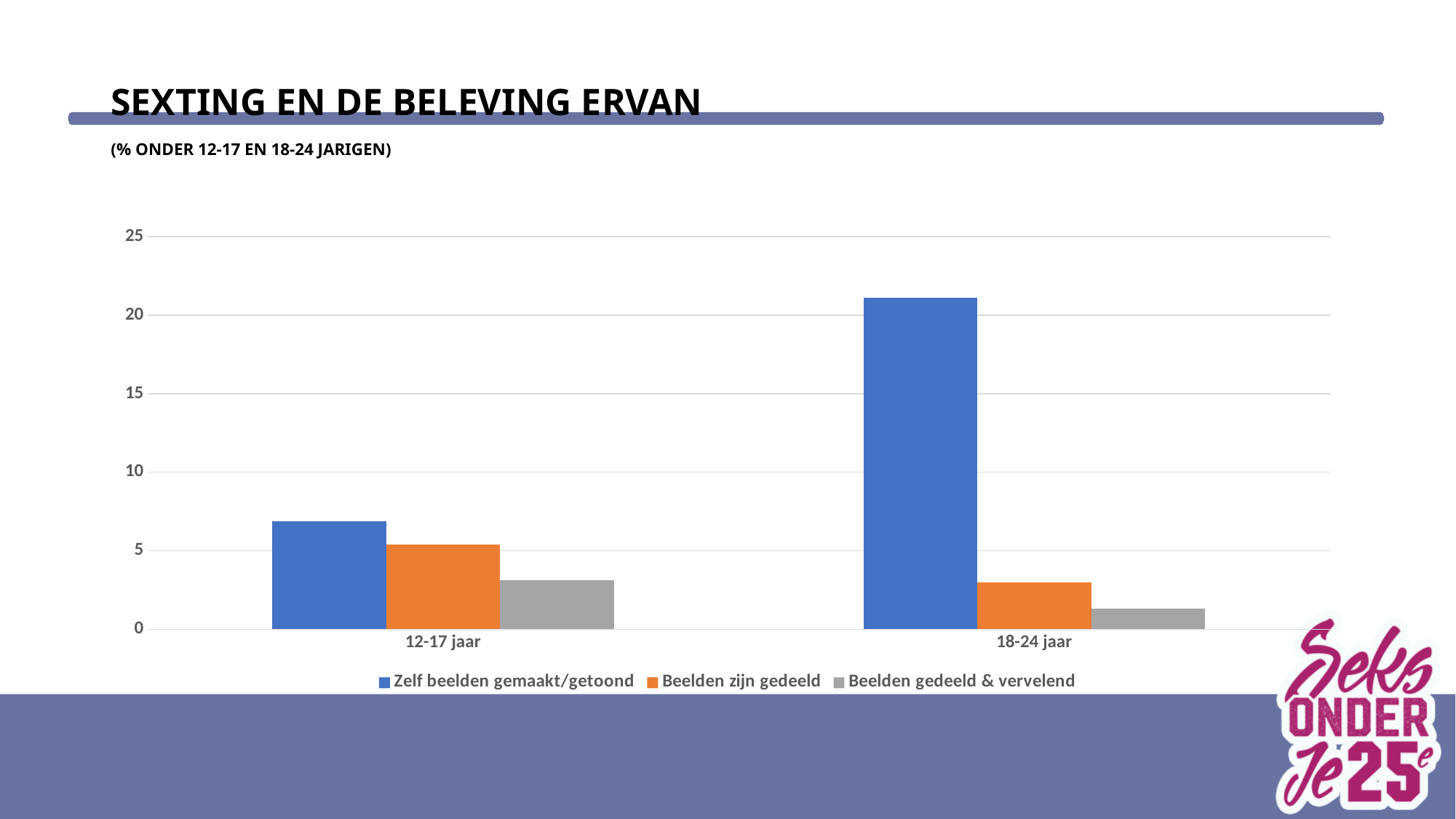
What is the title of the chart on the slide? SEXTING EN DE BELEVING ERVAN How many series does the legend list? 3 Which is larger: 'Beelden zijn gedeeld' for 12-17 jaar or 'Beelden zijn gedeeld' for 18-24 jaar? 12-17 jaar Is the value for 'Beelden gedeeld & vervelend' among 18-24 jaar greater or less than 5? less Which series is shown in orange in the legend? Beelden zijn gedeeld Is the value for 'Beelden zijn gedeeld' among 12-17 jaar greater or less than 5? greater Is the value for 'Zelf beelden gemaakt/getoond' among 12-17 jaar greater or less than 10? less Which age group has the lowest value for 'Beelden gedeeld & vervelend'? 18-24 jaar How many age-group categories are shown on the x axis? 2 Which age group has the highest value for 'Zelf beelden gemaakt/getoond'? 18-24 jaar What kind of chart is shown on the slide? bar chart